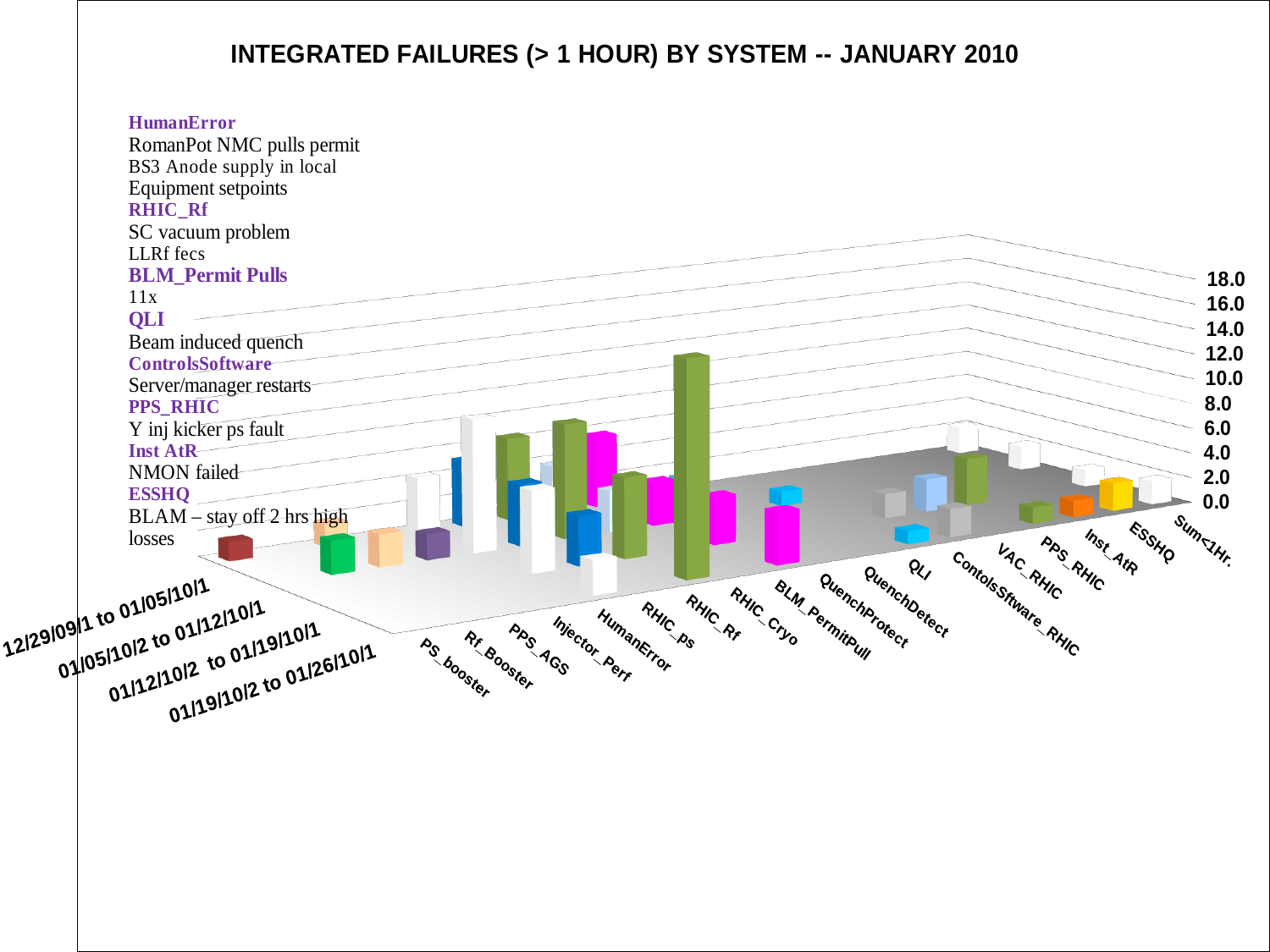
Which system category has the tallest bar in the chart? RHIC_Rf What is the title of the chart? INTEGRATED FAILURES (> 1 HOUR) BY SYSTEM -- JANUARY 2010 Which is larger, the tallest bar for HumanError or the tallest bar for PPS_RHIC? HumanError How many weekly date-range series are plotted in the chart? 4 Which is larger, the tallest bar for RHIC_Rf or the tallest bar for ESSHQ? RHIC_Rf What is the highest value shown on the vertical axis of the chart? 18.0 What kind of chart is shown on the slide? bar chart Is the tallest bar for RHIC_Rf greater or less than 8.0? greater How many system categories are shown along the x axis of the chart? 18 What is the label of the last category on the x axis of the chart? Sum<1Hr. Is the bar for VAC_RHIC greater or less than 6.0? less Is the bar for PS_booster in the first date range greater or less than 4.0? less